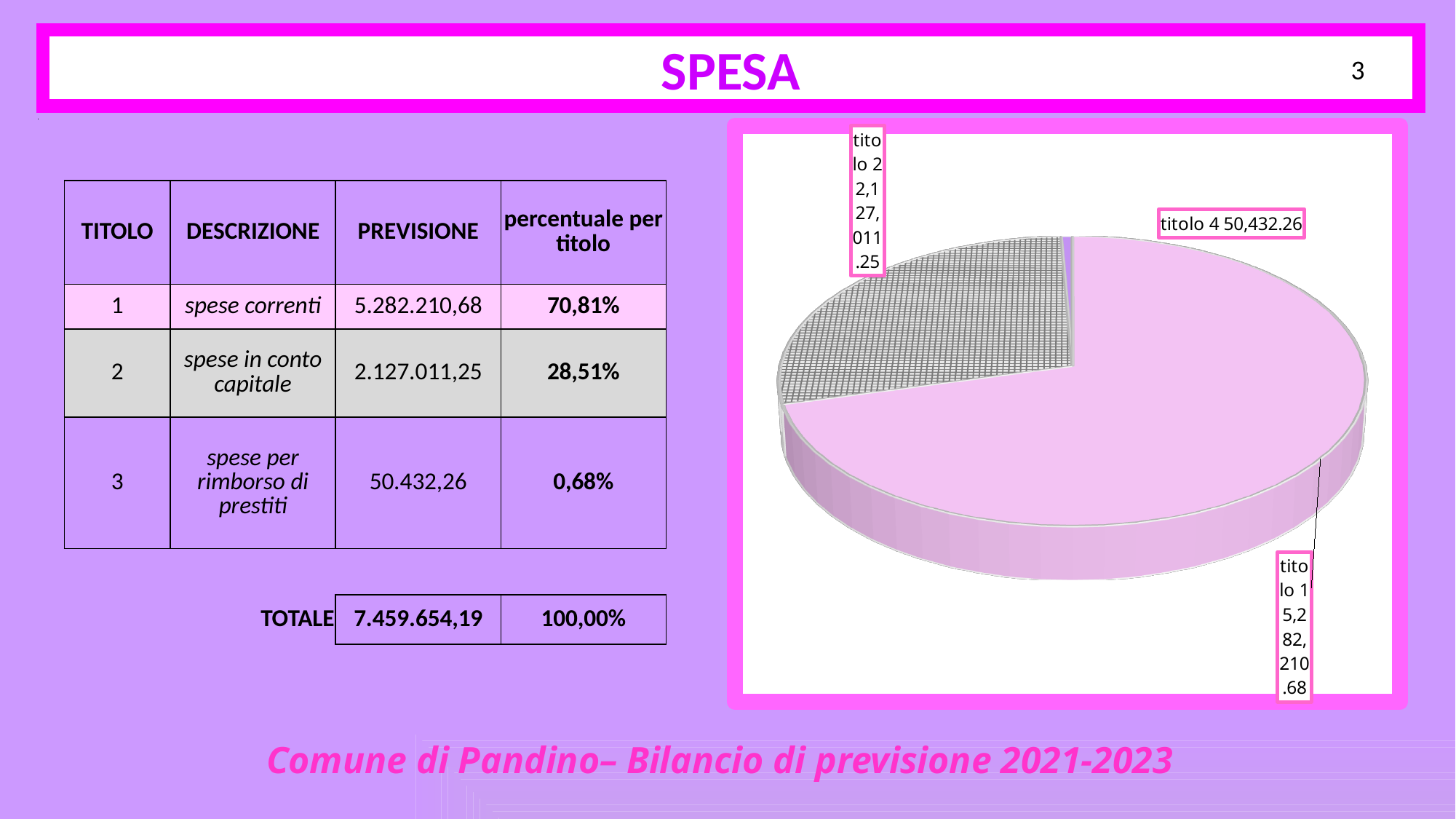
Which slice of the pie chart is the largest? titolo 1 What is the difference between the values labelled for titolo 1 and titolo 2 in the pie chart? 3,155,199.43 Which slice of the pie chart is drawn with a grey crosshatch pattern? titolo 2 What is the title shown at the top of the slide containing the pie chart? SPESA What value is labelled for titolo 4 in the pie chart? 50,432.26 In the pie chart, which is larger, titolo 2 or titolo 4? titolo 2 What kind of chart is shown on the slide? pie chart Which slice of the pie chart is the smallest? titolo 4 What value is labelled for titolo 2 in the pie chart? 2,127,011.25 What is the total of the three values labelled in the pie chart? 7,459,654.19 What value is labelled for titolo 1 in the pie chart? 5,282,210.68 How many slices does the pie chart have? 3